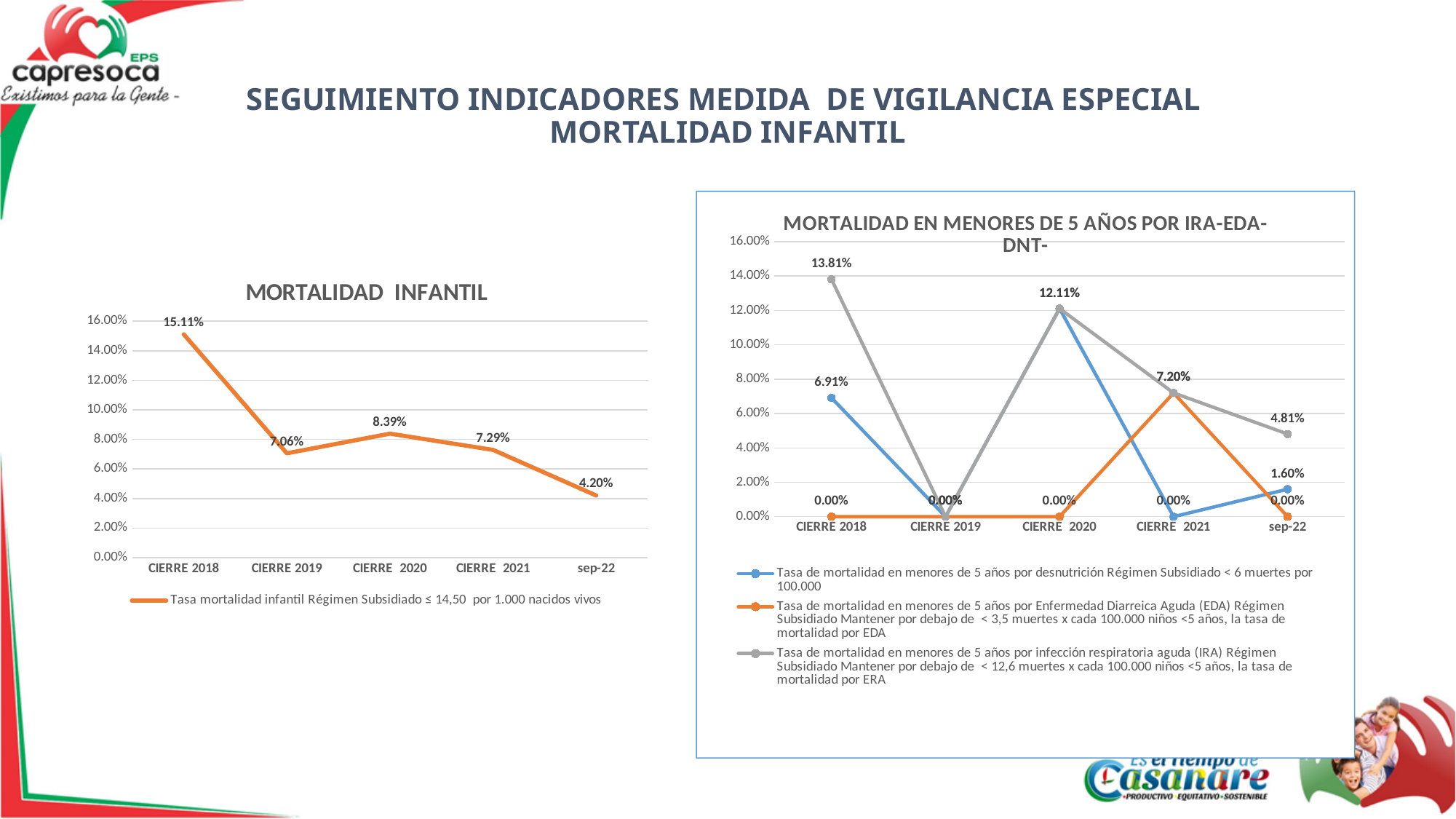
In the MORTALIDAD INFANTIL chart, which period has the highest value? CIERRE 2018 In the MORTALIDAD INFANTIL chart, how many periods are plotted on the x axis? 5 In the MORTALIDAD INFANTIL chart, what is the value for sep-22? 4.20% In the MORTALIDAD INFANTIL chart, what is the difference between the values for CIERRE 2018 and CIERRE 2019? 8.05% In the MORTALIDAD EN MENORES DE 5 AÑOS POR IRA-EDA-DNT chart, what is the value of the desnutrición (blue) series for sep-22? 1.60% In the MORTALIDAD EN MENORES DE 5 AÑOS POR IRA-EDA-DNT chart, what is the value of the IRA (gray) series for CIERRE 2018? 13.81% In the MORTALIDAD EN MENORES DE 5 AÑOS POR IRA-EDA-DNT chart, what is the value of the IRA (gray) series for sep-22? 4.81% In the MORTALIDAD INFANTIL chart, what is the value for CIERRE 2018? 15.11% In the MORTALIDAD INFANTIL chart, which is larger, the value for CIERRE 2020 or CIERRE 2021? CIERRE 2020 How many series does the legend of the MORTALIDAD EN MENORES DE 5 AÑOS POR IRA-EDA-DNT chart list? 3 In the MORTALIDAD INFANTIL chart, which period has the lowest value? sep-22 What kind of chart is the MORTALIDAD INFANTIL chart? Line chart